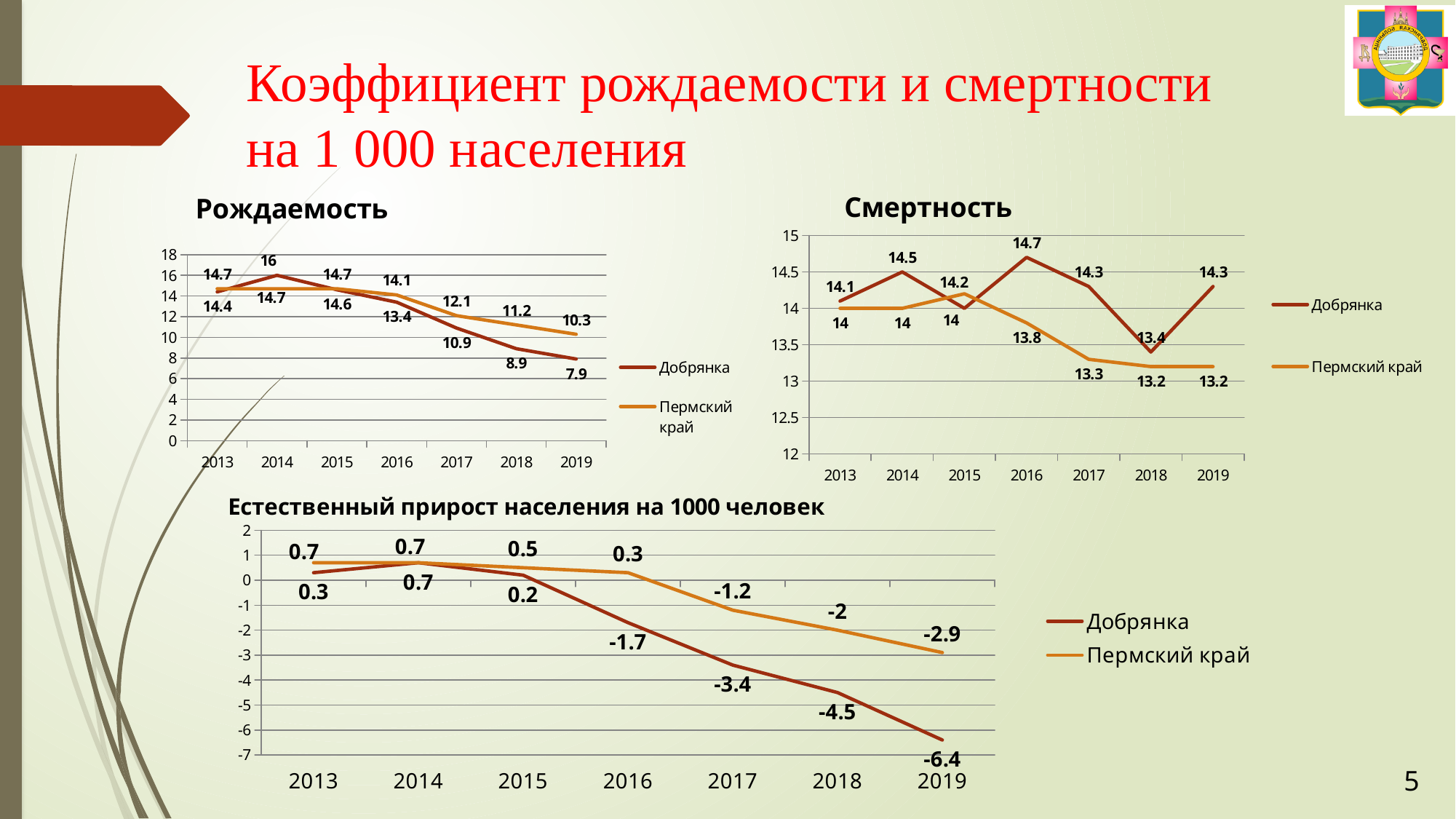
In the Рождаемость chart, in which year is the Добрянка value highest? 2014 In the Естественный прирост населения на 1000 человек chart, what is the value for Пермский край in 2018? -2 In the Естественный прирост населения на 1000 человек chart, what is the value for Добрянка in 2019? -6.4 In the Смертность chart, in which year is the Добрянка value lowest? 2018 What type of chart is the Естественный прирост населения на 1000 человек chart? Line chart In the Смертность chart, what is the value for Пермский край in 2017? 13.3 In the Рождаемость chart, what is the value for Добрянка in 2014? 16 In the Рождаемость chart, what is the value for Пермский край in 2019? 10.3 In the Естественный прирост населения на 1000 человек chart, how many years are shown on the x axis? 7 In the Рождаемость chart, what is the difference between Пермский край and Добрянка in 2019? 2.4 In the Смертность chart, which series has the larger value in 2019, Добрянка or Пермский край? Добрянка In the Смертность chart, what is the value for Добрянка in 2016? 14.7